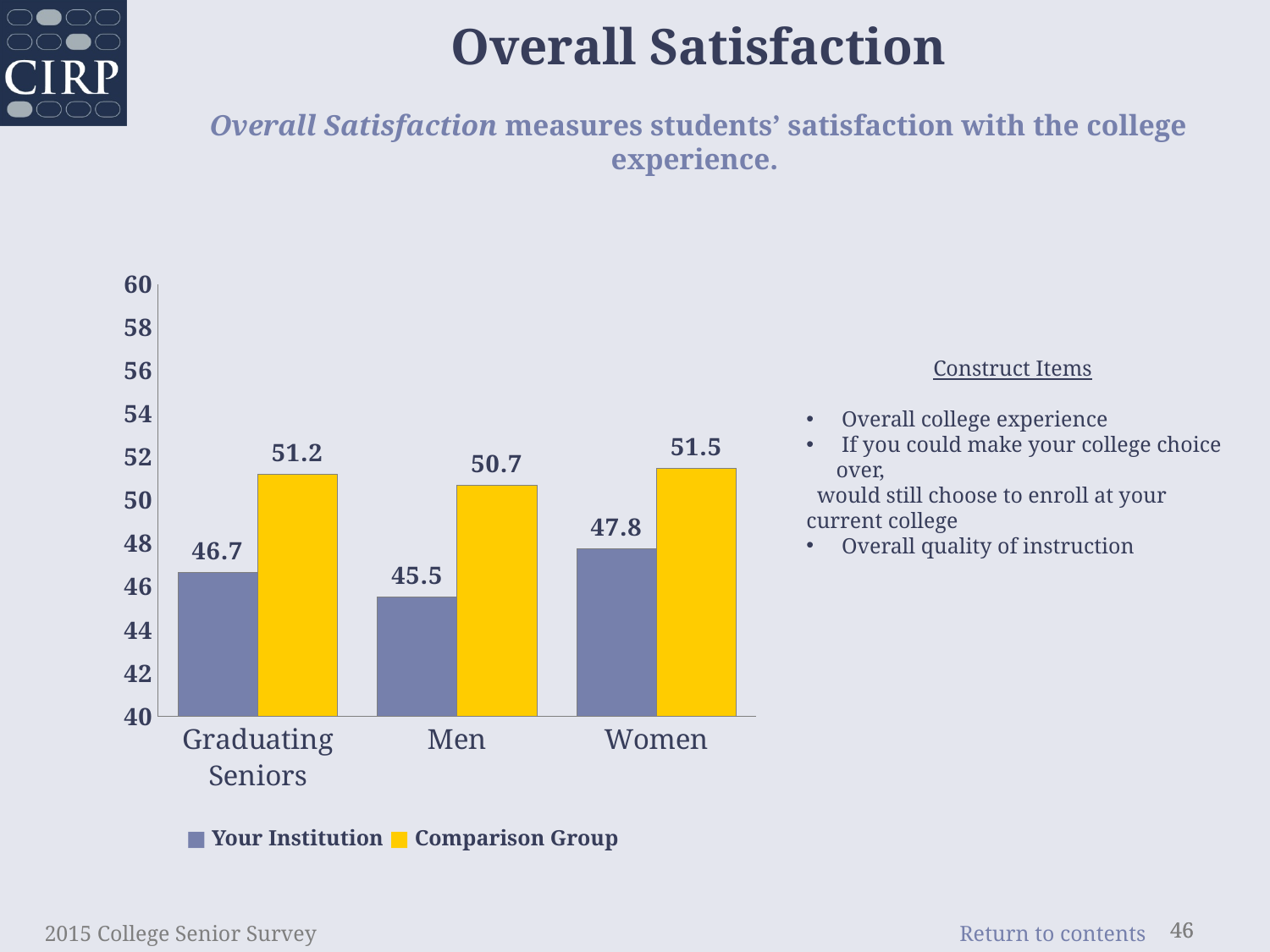
What is the Comparison Group value for Men? 50.7 What is the Your Institution value for Graduating Seniors? 46.7 How many categories are shown on the x axis? 3 How many series does the legend list? 2 Is the Your Institution value for Men greater or less than 46? less What is the difference between the Comparison Group and Your Institution values for Women? 3.7 What is the difference between the Comparison Group and Your Institution values for Men? 5.2 Which category has the lowest Your Institution value? Men Which category has the highest Comparison Group value? Women What kind of chart is shown on the slide? bar chart What is the Your Institution value for Women? 47.8 For Graduating Seniors, which is larger: Your Institution or Comparison Group? Comparison Group